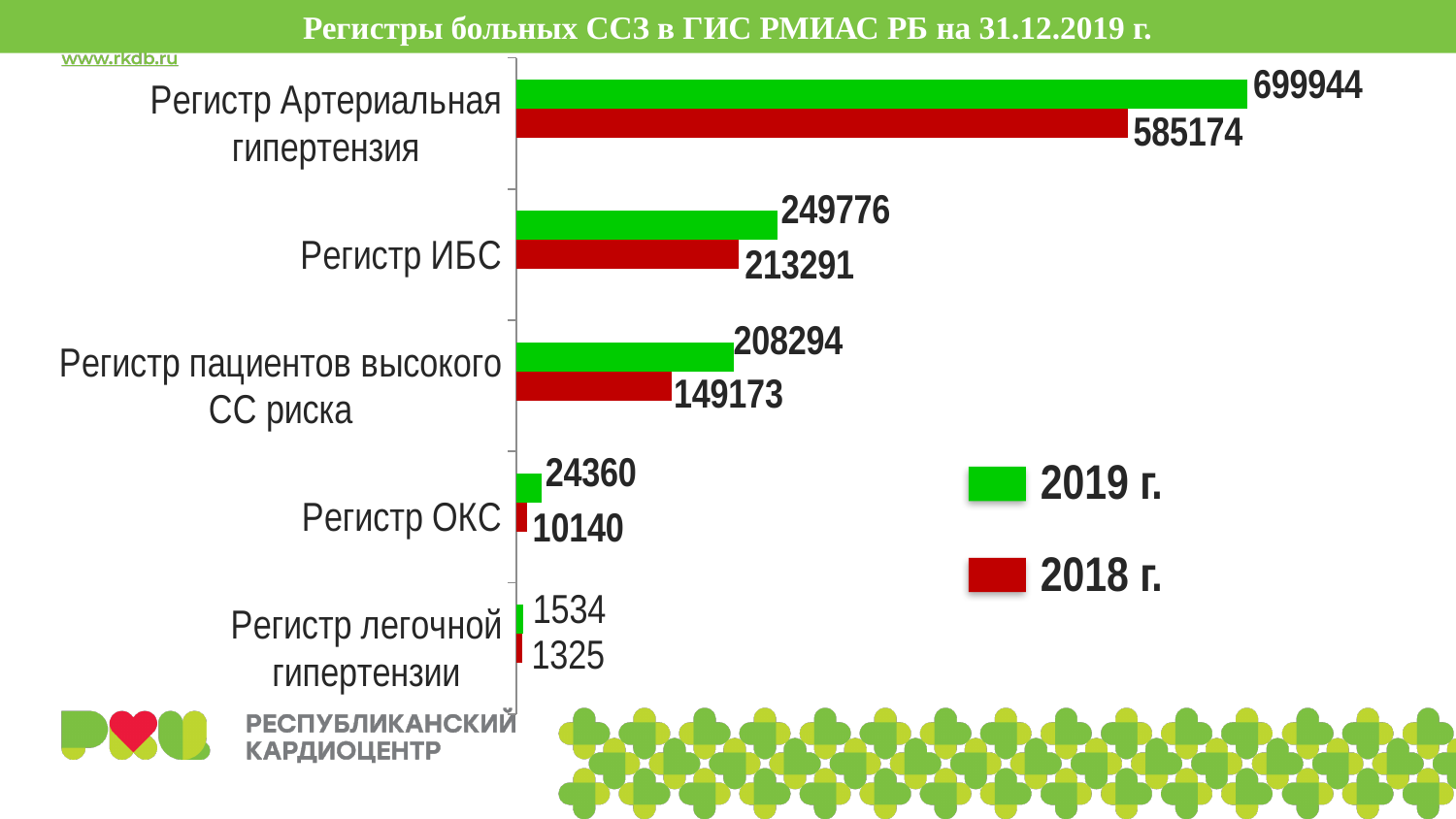
Which is larger for Регистр пациентов высокого СС риска: the 2019 г. value or the 2018 г. value? 2019 г. Which register has the lowest 2018 г. value? Регистр легочной гипертензии How many registers (categories) are shown in the chart? 5 How many series does the legend list? 2 Which register has the highest 2019 г. value? Регистр Артериальная гипертензия What is the 2018 г. value for Регистр ОКС? 10140 What is the 2019 г. value for Регистр легочной гипертензии? 1534 What kind of chart is shown on the slide? Bar chart What is the 2018 г. value for Регистр ИБС? 213291 What is the 2019 г. value for Регистр Артериальная гипертензия? 699944 What is the difference between the 2019 г. and 2018 г. values for Регистр ОКС? 14220 What is the difference between the 2019 г. and 2018 г. values for Регистр Артериальная гипертензия? 114770